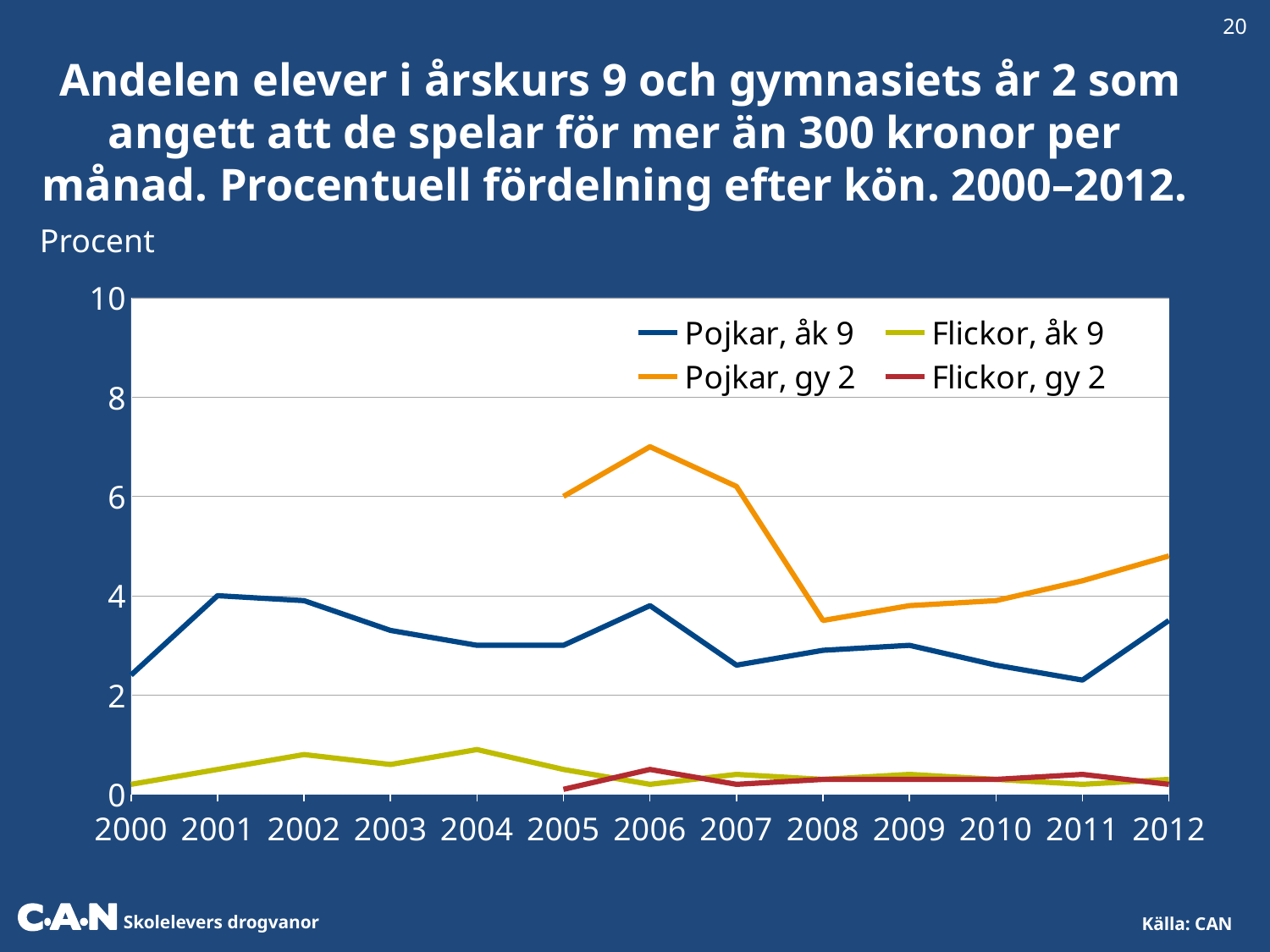
How many years are shown on the x axis? 13 What kind of chart is shown on the slide? line chart Is the value for Pojkar, gy 2 in 2006 greater or less than 6? greater Does the Pojkar, gy 2 series rise or fall from 2008 to 2012? rise In which year does the Pojkar, gy 2 series reach its highest value? 2006 Does the Pojkar, gy 2 series rise or fall from 2006 to 2008? fall In 2008, which is larger: Pojkar, gy 2 or Pojkar, åk 9? Pojkar, gy 2 Is the value for Pojkar, åk 9 in 2012 greater or less than 4? less In 2006, which is larger: Pojkar, åk 9 or Flickor, åk 9? Pojkar, åk 9 Which two series only begin in 2005? Pojkar, gy 2 and Flickor, gy 2 Is the value for Flickor, gy 2 in 2012 greater or less than 2? less How many series does the legend list? 4